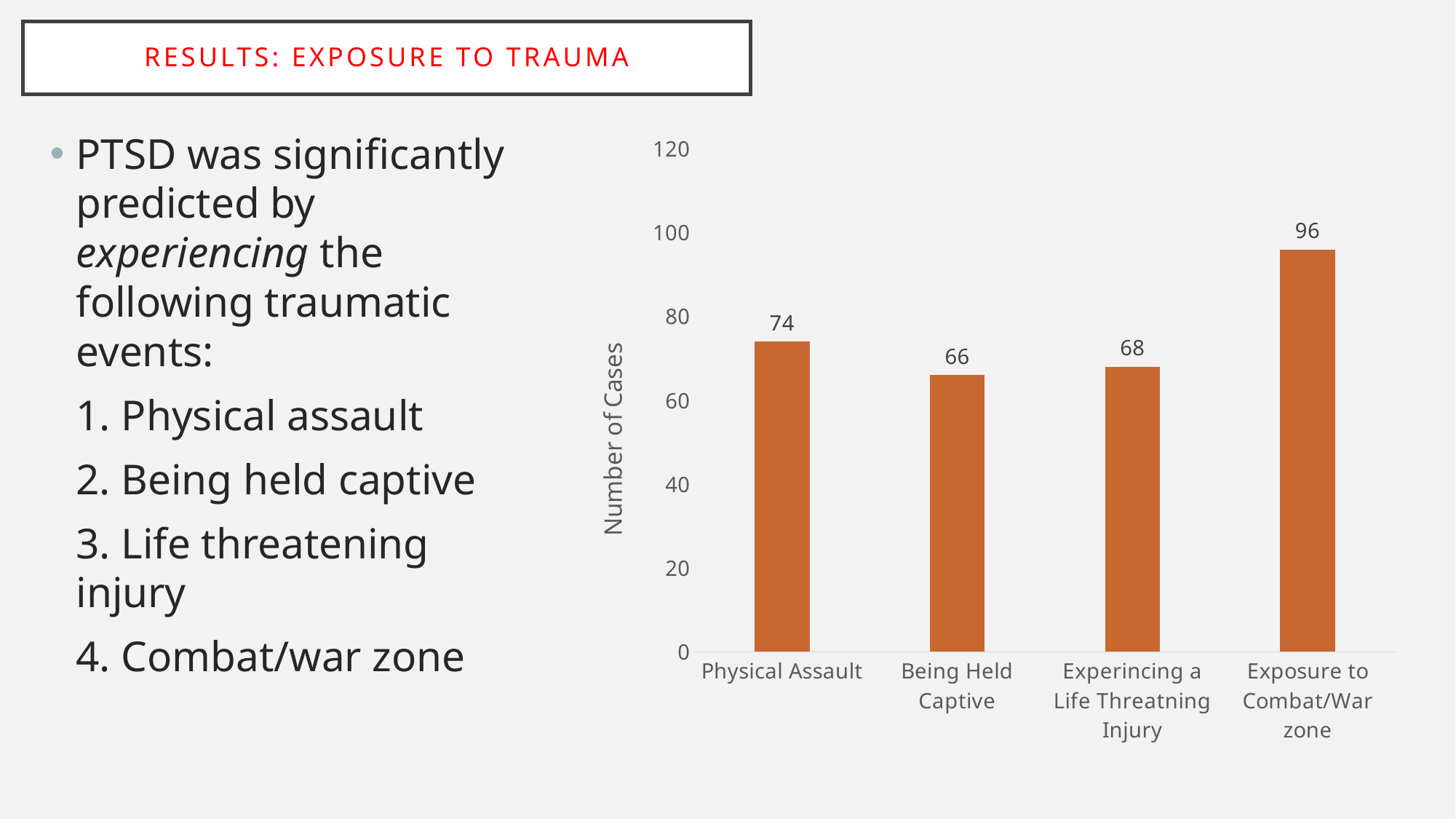
What is the difference in number of cases between Physical Assault and Being Held Captive? 8 Which category has the highest number of cases? Exposure to Combat/War zone What is the difference in number of cases between Exposure to Combat/War zone and Physical Assault? 22 What is the number of cases for Physical Assault? 74 Which has more cases, Physical Assault or Experincing a Life Threatning Injury? Physical Assault Is the value for Exposure to Combat/War zone greater or less than 80? greater What is the number of cases for Being Held Captive? 66 What is the number of cases for Experincing a Life Threatning Injury? 68 What is the number of cases for Exposure to Combat/War zone? 96 How many categories are shown in the chart? 4 What type of chart is shown on the slide? Bar chart Which category has the lowest number of cases? Being Held Captive